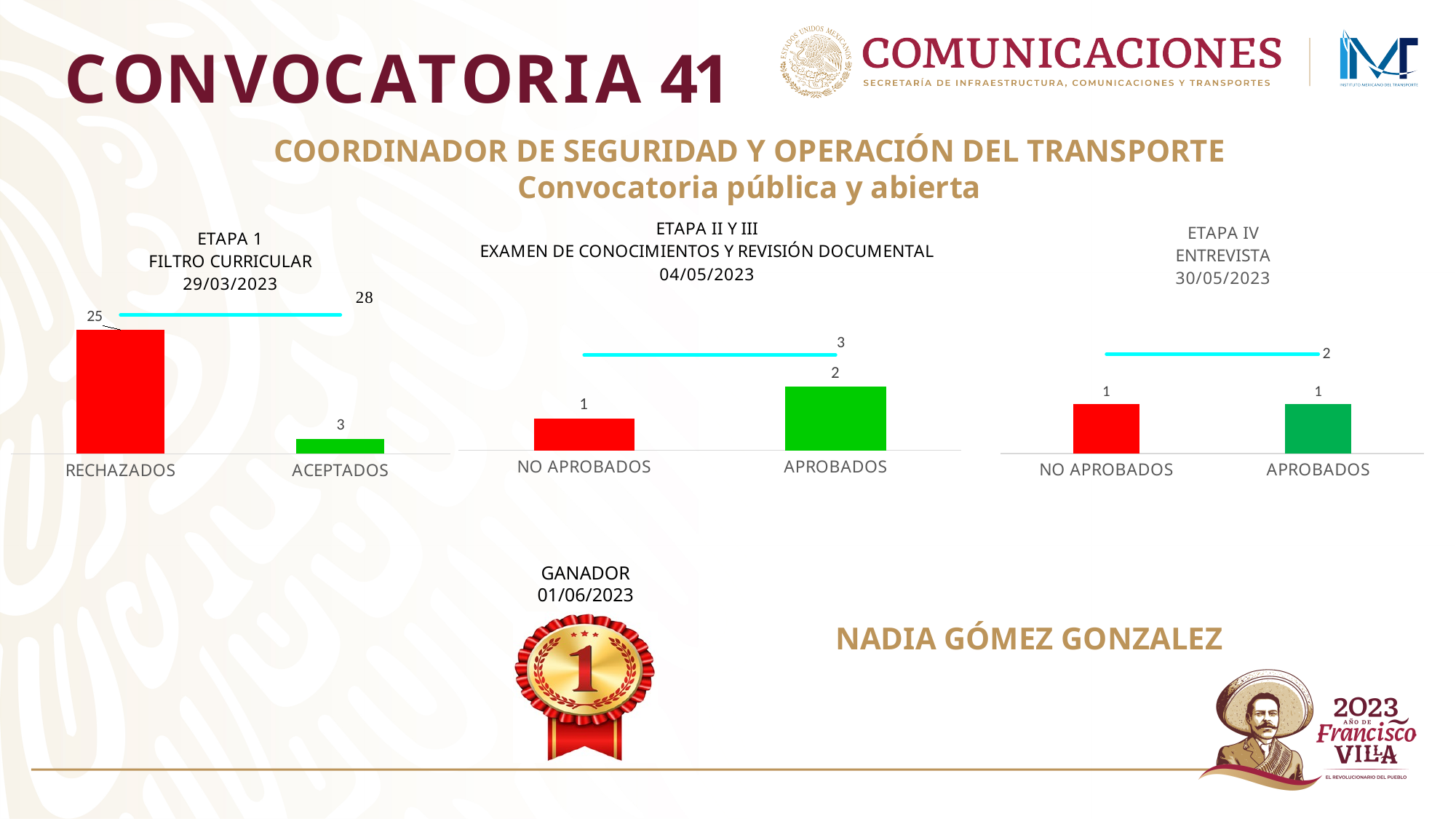
In the ETAPA II Y III EXAMEN DE CONOCIMIENTOS Y REVISIÓN DOCUMENTAL chart, what is the value for APROBADOS? 2 What kind of chart is the ETAPA 1 FILTRO CURRICULAR chart? Combination bar and line chart In the ETAPA II Y III EXAMEN DE CONOCIMIENTOS Y REVISIÓN DOCUMENTAL chart, what is the value for NO APROBADOS? 1 In the ETAPA 1 FILTRO CURRICULAR chart, what is the difference between RECHAZADOS and ACEPTADOS? 22 In the ETAPA 1 FILTRO CURRICULAR chart, what is the value for RECHAZADOS? 25 In the ETAPA II Y III chart, which is larger, NO APROBADOS or APROBADOS? APROBADOS In the ETAPA IV ENTREVISTA chart, what is the value for APROBADOS? 1 In the ETAPA 1 FILTRO CURRICULAR chart, what value is labelled on the cyan line above the bars? 28 In the ETAPA 1 FILTRO CURRICULAR chart, which category has the highest value? RECHAZADOS In the ETAPA 1 FILTRO CURRICULAR chart, what is the value for ACEPTADOS? 3 In the ETAPA IV ENTREVISTA chart, what value is labelled on the cyan line? 2 How many categories does the ETAPA IV ENTREVISTA chart show? 2